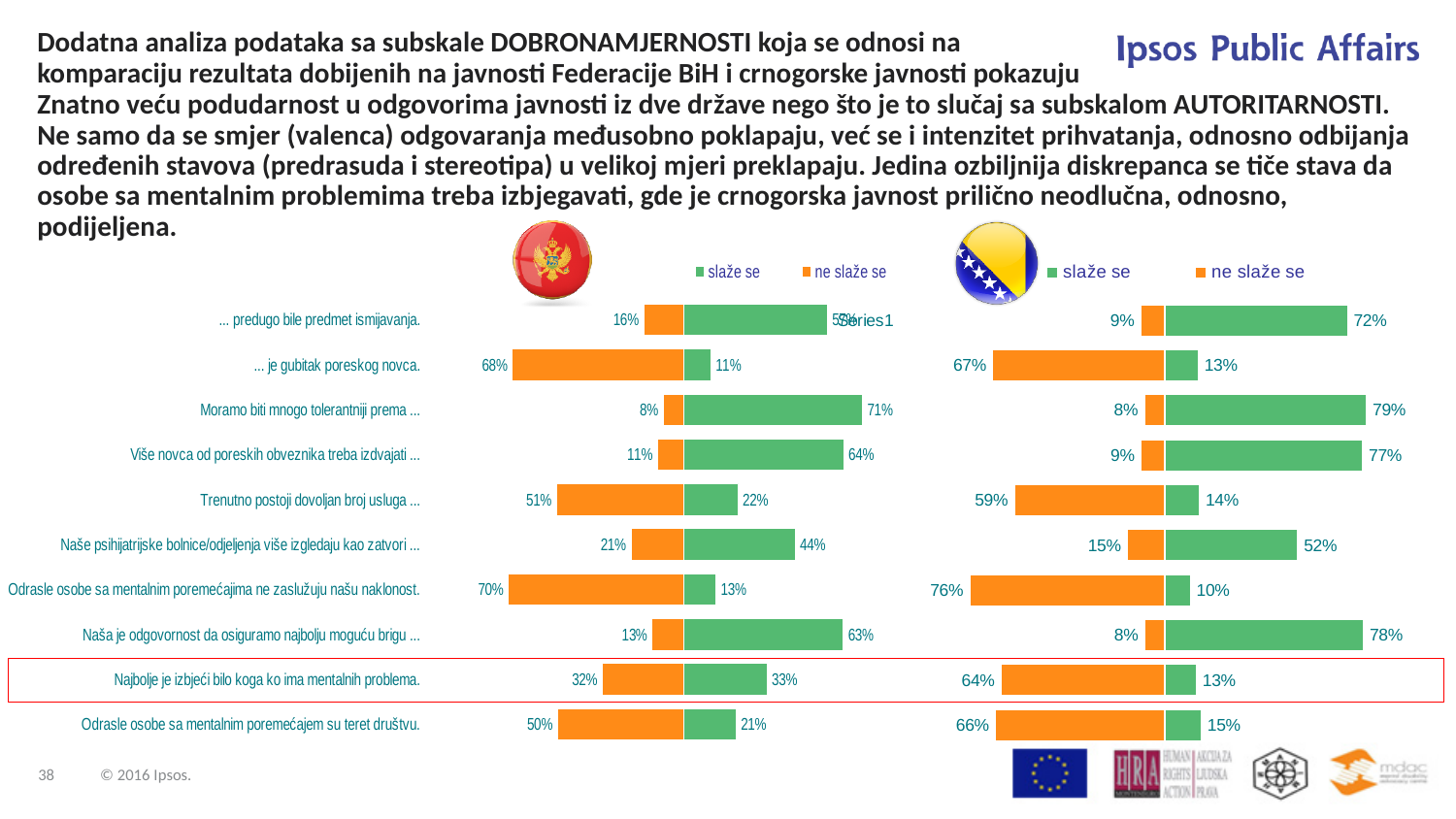
In the left chart, what is the 'slaže se' value for 'Moramo biti mnogo tolerantniji prema ...'? 71% What type of chart is the left chart? bar chart Which is larger: the 'ne slaže se' value for 'Trenutno postoji dovoljan broj usluga ...' in the left chart or in the right chart? right chart In the right chart, which colour represents 'ne slaže se'? orange How many series does the legend of the right chart list? 2 How many categories are shown in the left chart? 10 In the left chart, what is the difference between the 'ne slaže se' and 'slaže se' values for 'Najbolje je izbjeći bilo koga ko ima mentalnih problema.'? 1% In the right chart, which category has the lowest 'slaže se' value? Odrasle osobe sa mentalnim poremećajima ne zaslužuju našu naklonost. In the right chart, which category has the highest 'slaže se' value? Moramo biti mnogo tolerantniji prema ... In the right chart, what is the difference between the 'slaže se' and 'ne slaže se' values for 'Naše psihijatrijske bolnice/odjeljenja više izgledaju kao zatvori ...'? 37% In the right chart, what is the 'ne slaže se' value for 'Najbolje je izbjeći bilo koga ko ima mentalnih problema.'? 64% In the left chart, what is the 'ne slaže se' value for 'Odrasle osobe sa mentalnim poremećajima ne zaslužuju našu naklonost.'? 70%